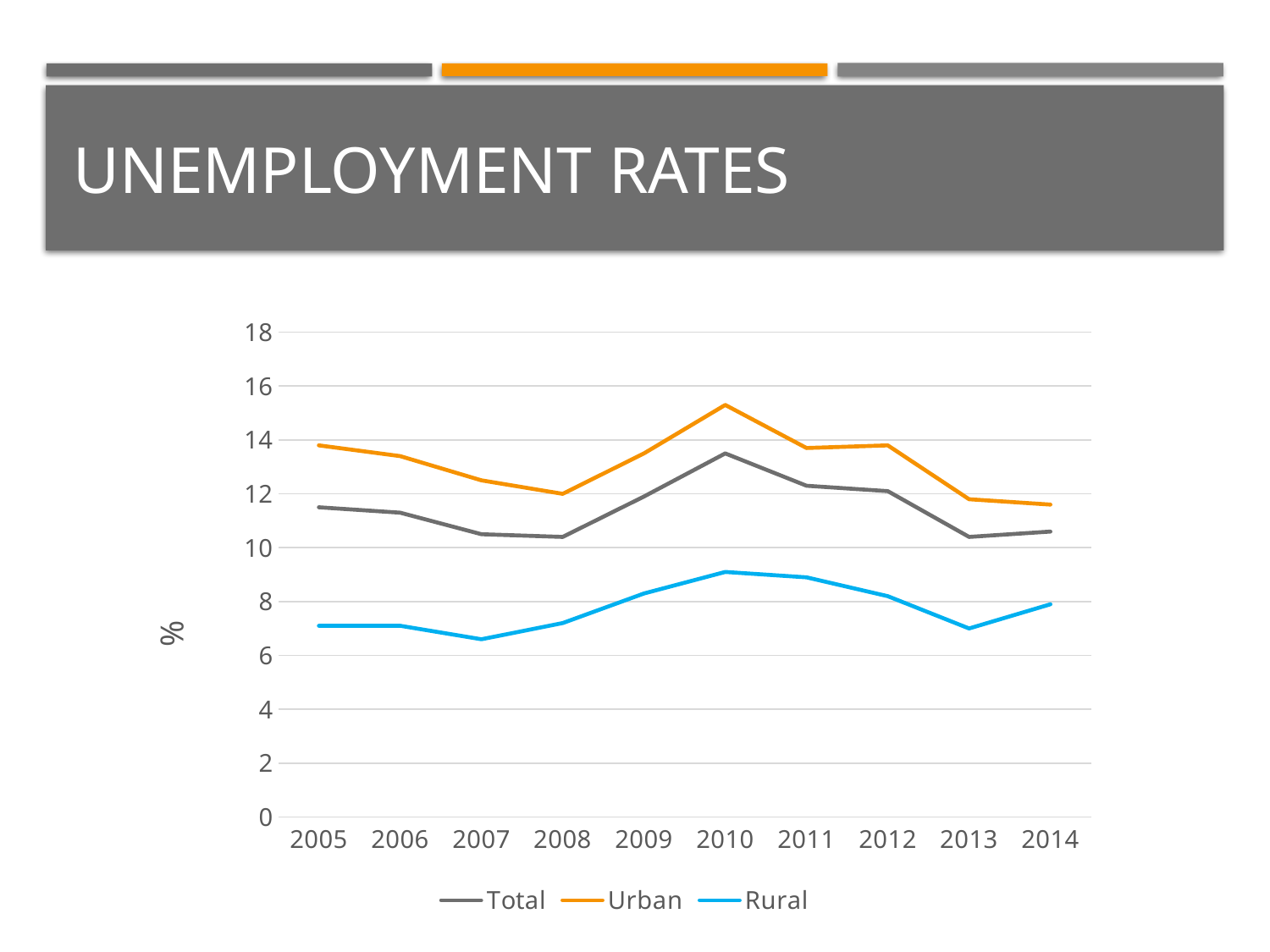
What is the title of the slide containing the chart? UNEMPLOYMENT RATES In which year does the Rural series reach its lowest value? 2007 Which series has the larger value in 2010, Urban or Rural? Urban What kind of chart is shown on the slide? line chart In which year does the Urban series reach its highest value? 2010 Is the Total value for 2005 greater or less than 10? greater In which year does the Total series reach its highest value? 2010 Is the Urban value for 2010 greater or less than 14? greater Does the Urban series rise or fall from 2010 to 2014? fall Is the Rural value for 2007 greater or less than 8? less How many years are shown on the x axis? 10 How many series does the legend list? 3